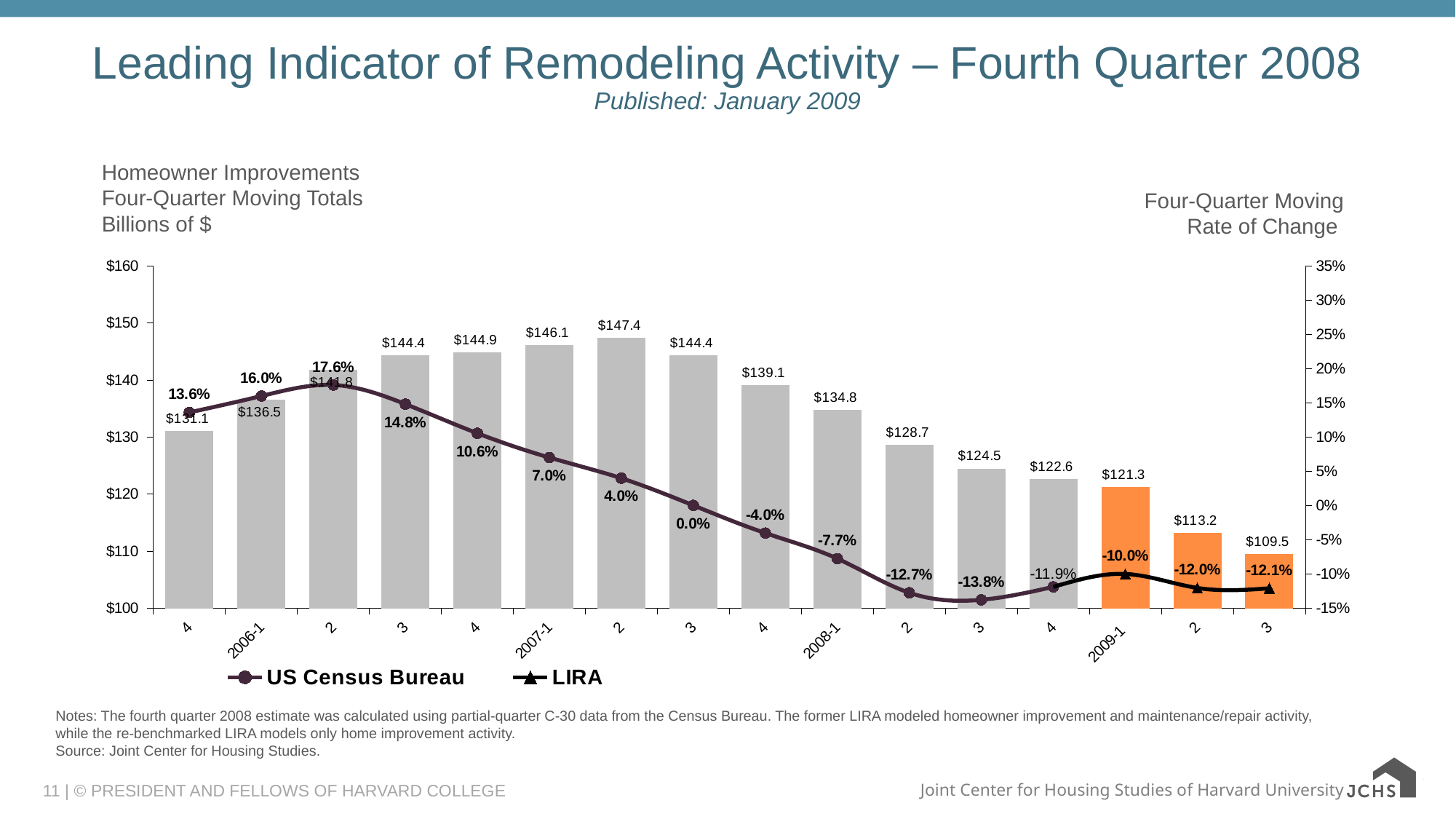
Which quarter has the highest homeowner improvements bar? 2007-2 What is the highest four-quarter moving rate of change shown on the line? 17.6% How many series does the legend list? 2 What is the four-quarter moving rate of change shown for 2009-1? -10.0% What is the difference between the homeowner improvements bars for 2008-1 and 2009-1? $13.5 Is the homeowner improvements value for 2008-2 greater or less than $130? less What kind of chart is shown on the slide? Combined bar and line chart Does the four-quarter moving rate of change rise or fall from 2006-2 to 2008-3? fall What is the four-quarter moving total of homeowner improvements for the second quarter of 2007 (the bar labelled 2 after 2007-1)? $147.4 Which is larger, the homeowner improvements bar for 2008-4 or for 2009-1? 2008-4 What is the lowest homeowner improvements value shown on the chart? $109.5 How many quarterly bars are plotted on the chart? 16